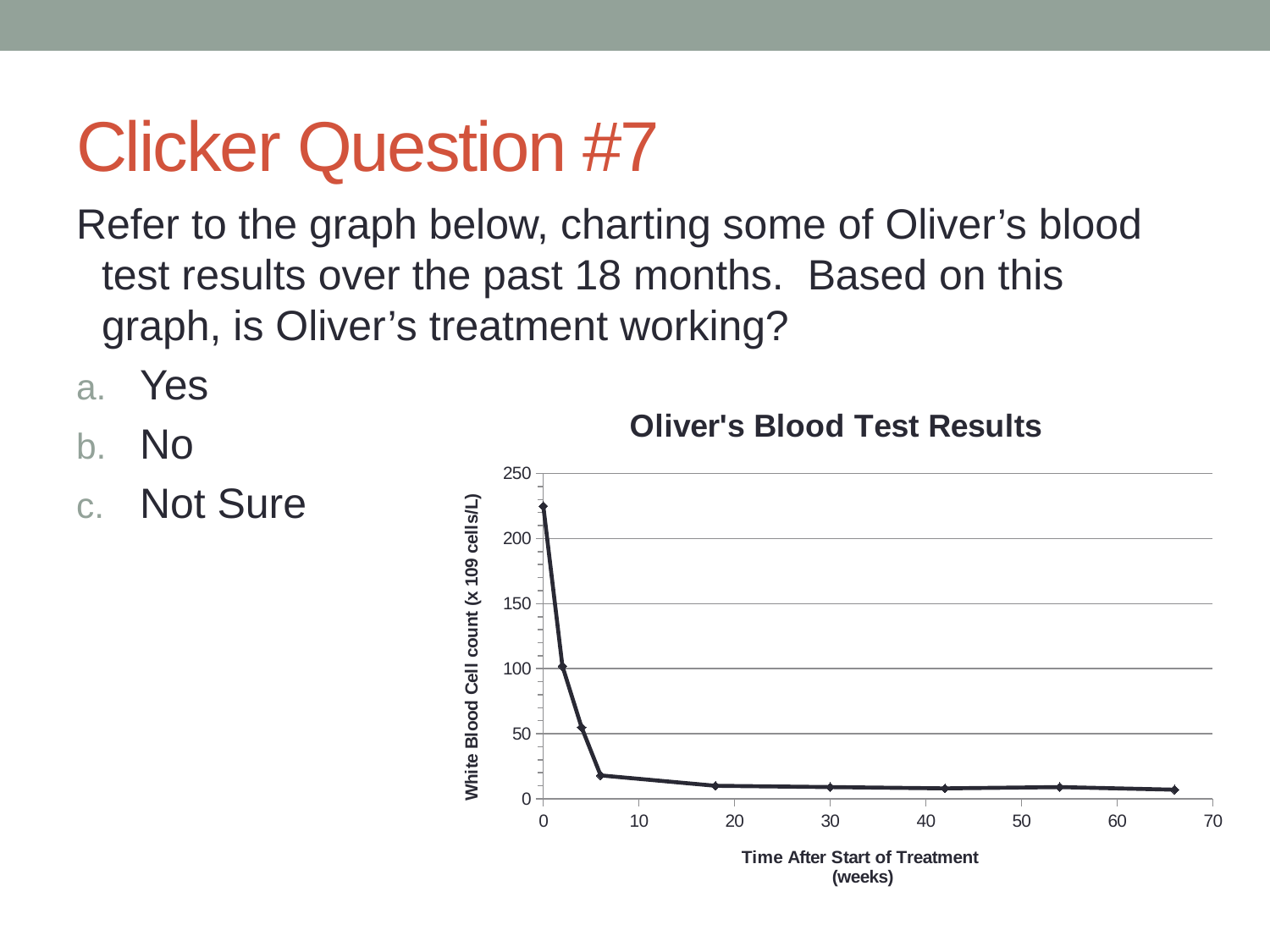
Is the white blood cell count at week 18 greater or less than 50? less What is the title of the chart? Oliver's Blood Test Results At which week is the white blood cell count highest? 0 What kind of chart is shown on the slide? line chart How many data points are plotted on the chart? 9 What is the label of the x axis of the chart? Time After Start of Treatment (weeks) Do the white blood cell count values rise or fall as time after start of treatment increases? fall Is the white blood cell count at week 0 greater or less than 200? greater Which is larger, the white blood cell count at week 2 or at week 6? week 2 Is the white blood cell count at week 2 greater or less than 150? less What is the highest value shown on the y axis of the chart? 250